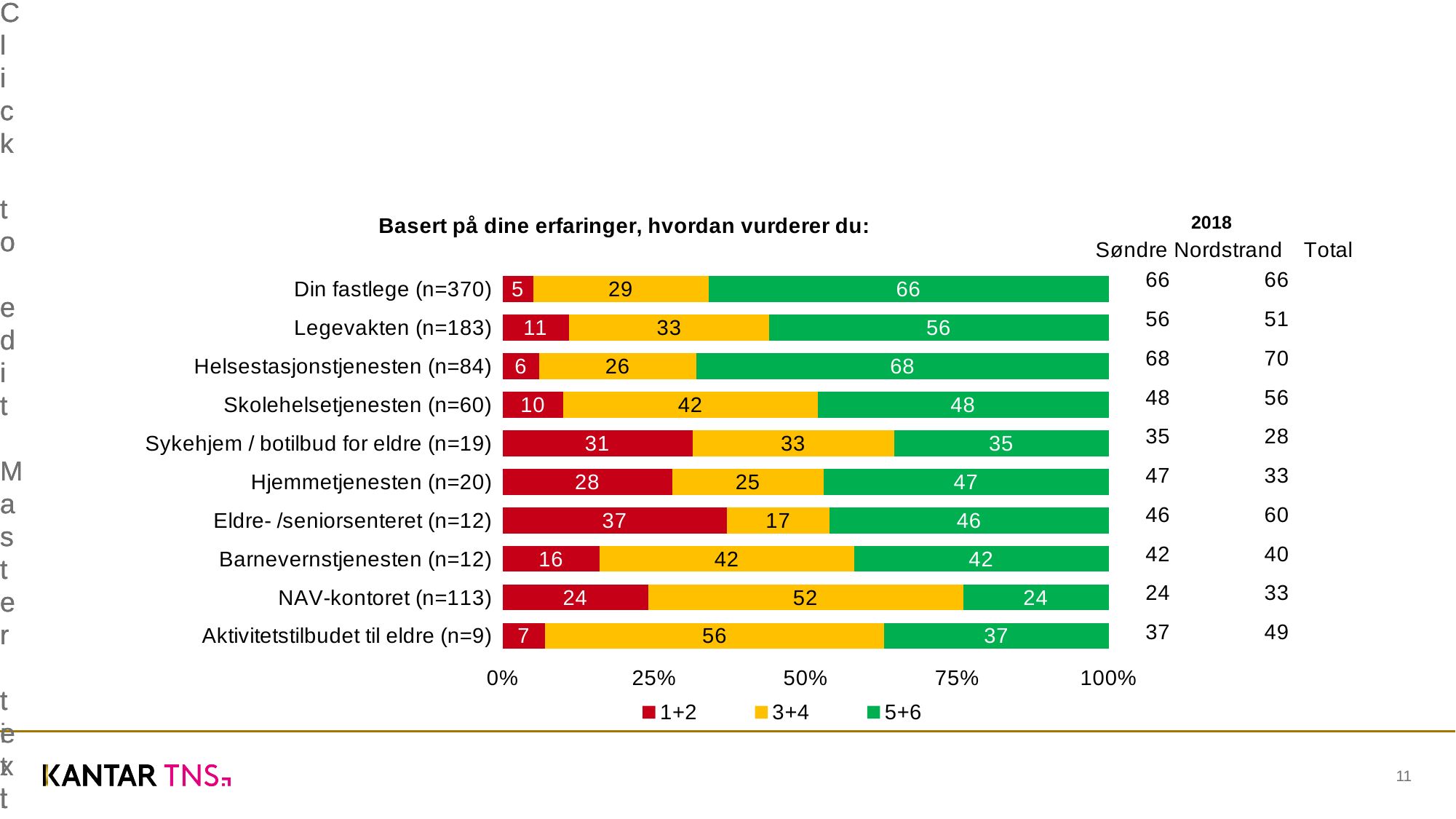
Which category has the lowest 5+6 value? NAV-kontoret (n=113) How many series does the legend list? 3 What is the 1+2 value for Sykehjem / botilbud for eldre (n=19)? 31 How many categories (services) are plotted in the chart? 10 Which category has the highest 5+6 value? Helsestasjonstjenesten (n=84) What is the total of the stacked bar for Hjemmetjenesten (n=20)? 100 Which category has the highest 1+2 value? Eldre- /seniorsenteret (n=12) What is the 3+4 value for NAV-kontoret (n=113)? 52 Which is larger: the 3+4 value for Aktivitetstilbudet til eldre (n=9) or the 3+4 value for Skolehelsetjenesten (n=60)? Aktivitetstilbudet til eldre (n=9) What is the difference between the 5+6 values for Din fastlege (n=370) and Legevakten (n=183)? 10 What is the 5+6 value for Din fastlege (n=370)? 66 What kind of chart is shown on the slide? Stacked bar chart